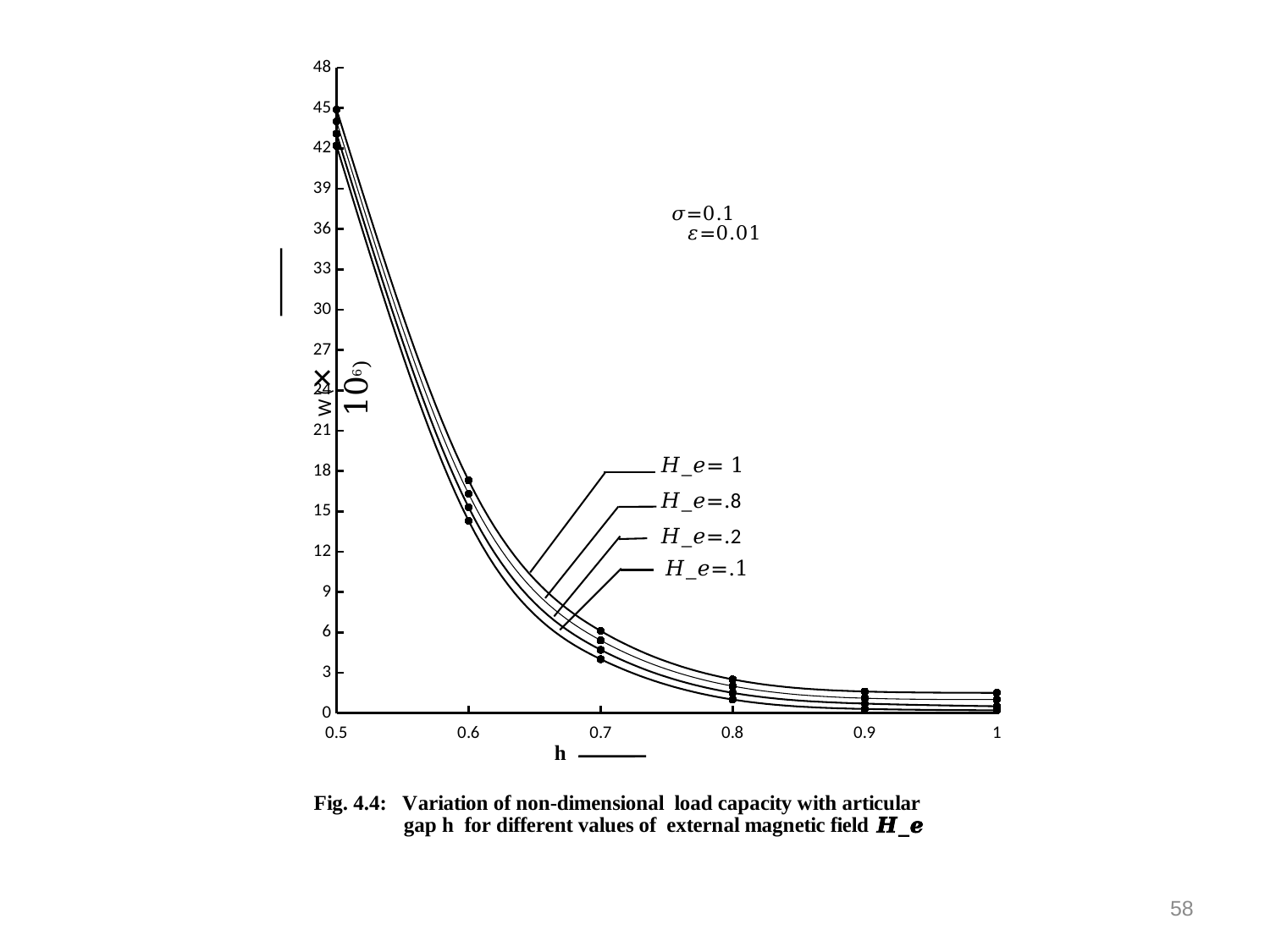
At h = 0.7, which is larger: the value for H_e = 1 or the value for H_e = .1? H_e = 1 How many curves (values of H_e) are labelled on the chart? 4 Which curve has the highest value at h = 0.6? H_e = 1 What kind of chart is shown on the slide? line chart Is the value for H_e = .1 at h = 0.6 greater or less than 18? less Is the value for H_e = 1 at h = 1 greater or less than 3? less How many h values are marked on the x axis? 6 Is the value for H_e = 1 at h = 0.5 greater or less than 42? greater Which curve has the lowest value at h = 0.6? H_e = .1 Do the curves rise or fall as h increases from 0.5 to 1? fall What values of σ and ε are stated on the chart? σ=0.1, ε=0.01